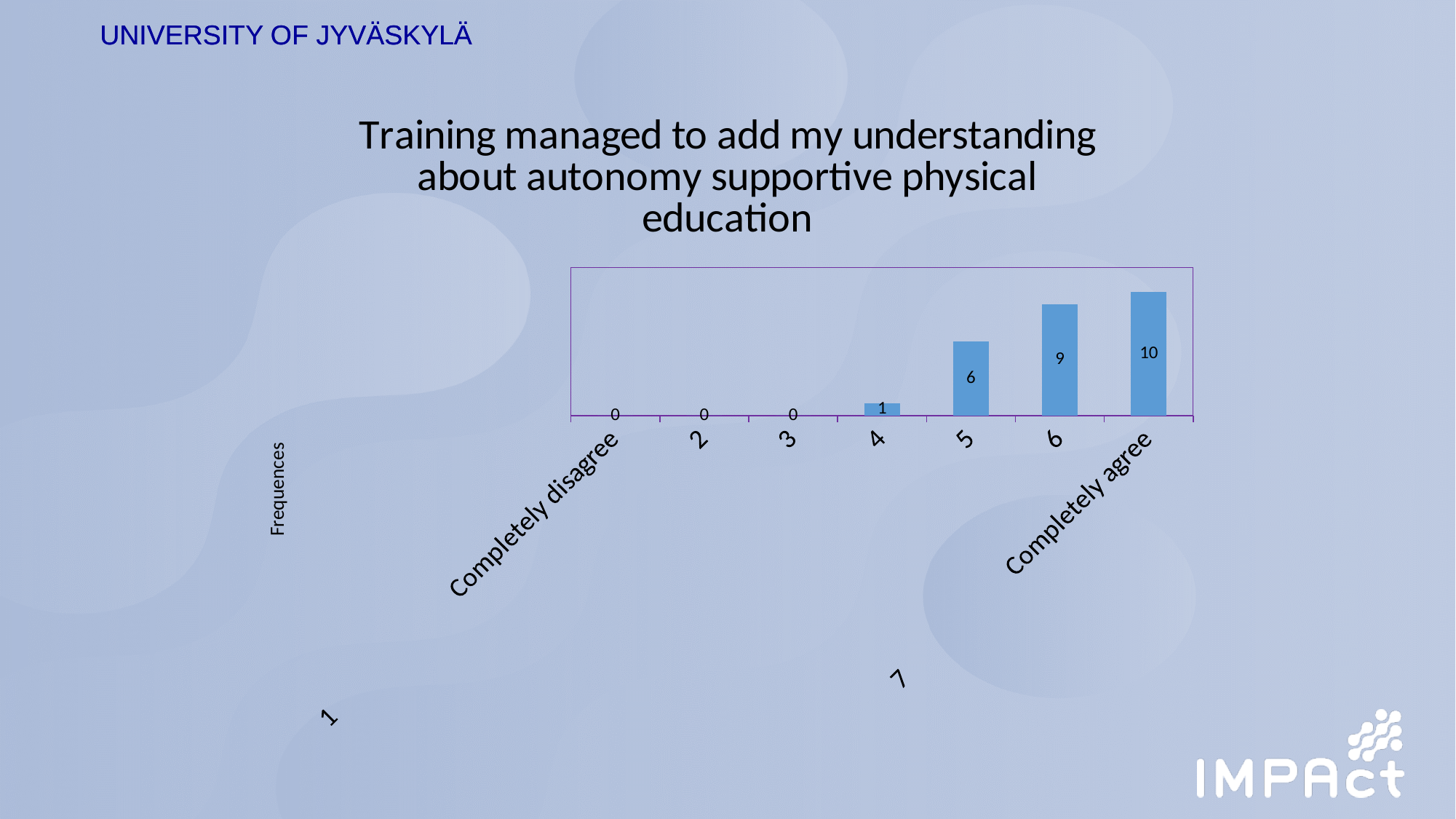
What is the value for category 6? 9 What is the value for category 4? 1 Which category has the highest value? Completely agree Which is larger, the value for category 5 or the value for category 4? category 5 What is the difference between the values for 'Completely agree' and category 6? 1 What is the value for the 'Completely agree' category? 10 What is the value for category 5? 6 Do the values rise or fall from 'Completely disagree' to 'Completely agree'? rise What is the difference between the values for category 6 and category 5? 3 What is the value for the 'Completely disagree' category? 0 How many categories are shown on the x axis? 7 What kind of chart is shown? bar chart